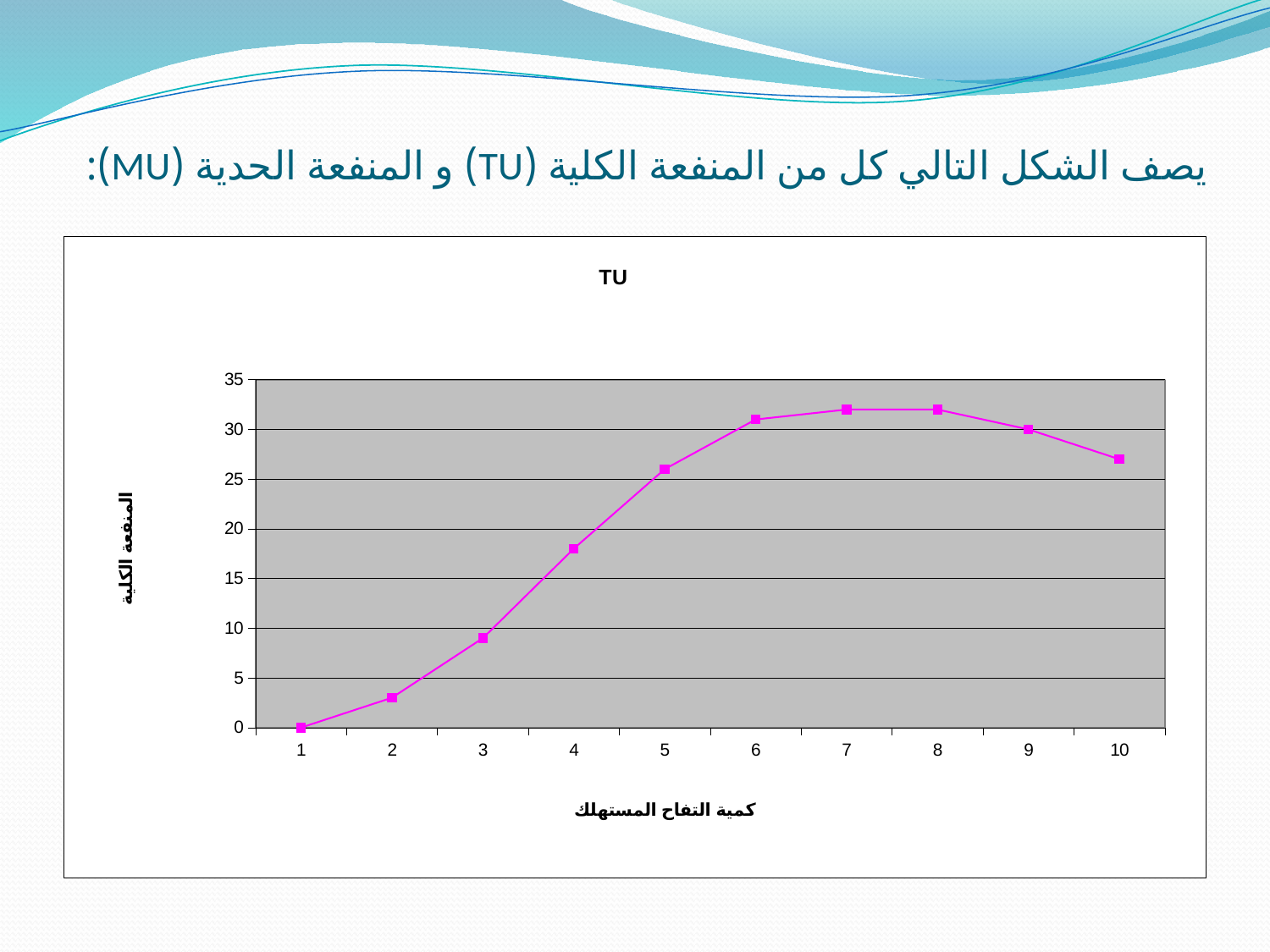
What is the label on the x axis? كمية التفاح المستهلك What is the value at quantity 1? 0 Is the value at quantity 2 greater or less than 5? less At which quantity is the value lowest? 1 How many data points are plotted on the line? 10 What is the title of the chart? TU Is the value at quantity 4 greater or less than 20? less What kind of chart is shown on the slide? line chart Is the value at quantity 10 greater or less than 25? greater Which is larger, the value at quantity 4 or the value at quantity 9? quantity 9 Do the values rise or fall as the quantity increases from 1 to 6? rise